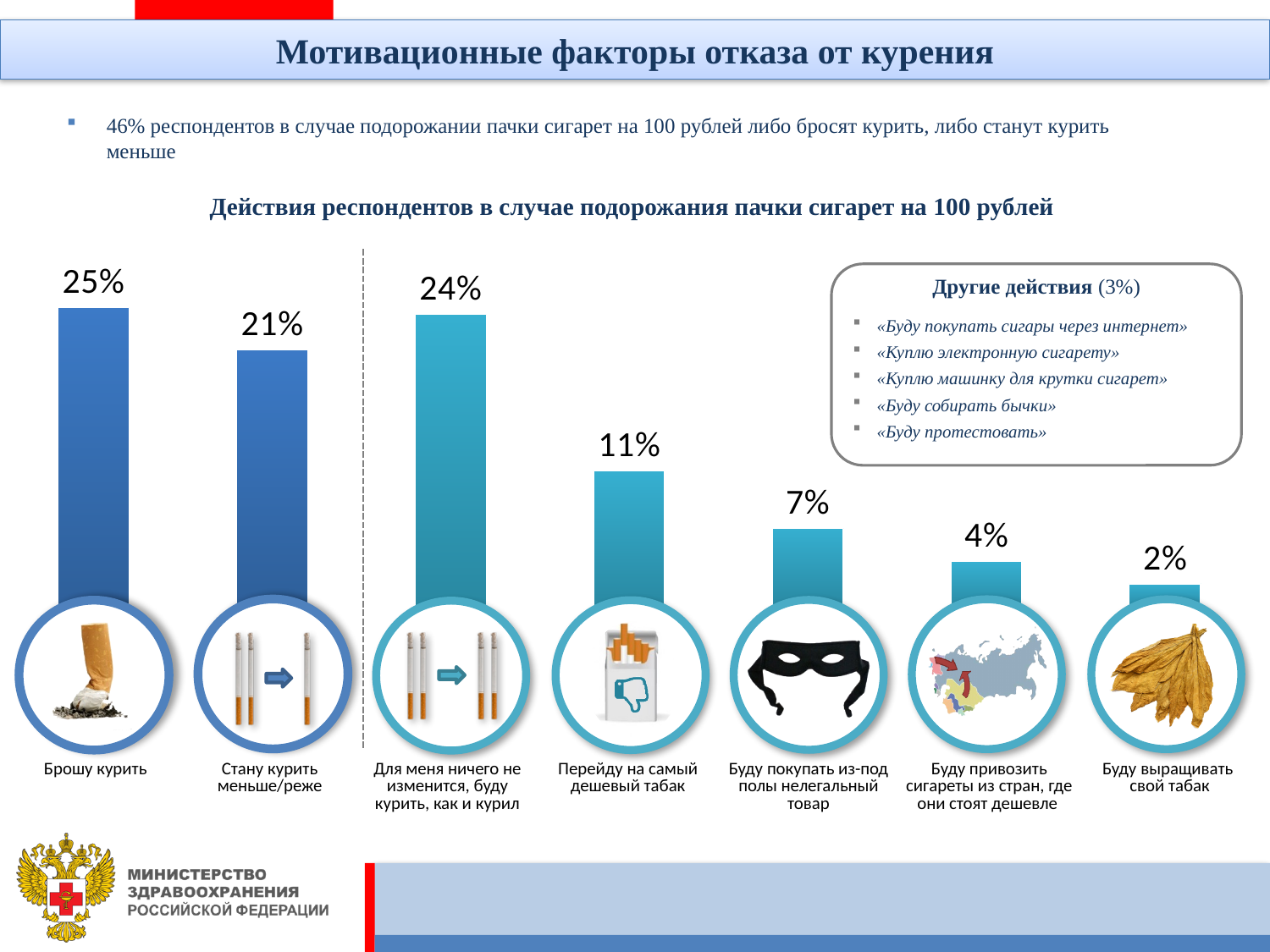
What kind of chart is shown on the slide? bar chart Which is larger: «Буду покупать из-под полы нелегальный товар» or «Буду привозить сигареты из стран, где они стоят дешевле»? Буду покупать из-под полы нелегальный товар What is the value for «Буду привозить сигареты из стран, где они стоят дешевле»? 4% What is the value for «Брошу курить»? 25% What is the title of the chart? Действия респондентов в случае подорожания пачки сигарет на 100 рублей What is the difference between «Для меня ничего не изменится, буду курить, как и курил» and «Перейду на самый дешевый табак»? 13% How many categories are shown in the bar chart? 7 Which category has the highest value? Брошу курить What is the difference between «Брошу курить» and «Стану курить меньше/реже»? 4% What is the combined total of «Брошу курить» and «Стану курить меньше/реже»? 46% What is the value for «Перейду на самый дешевый табак»? 11% Which category has the lowest value? Буду выращивать свой табак